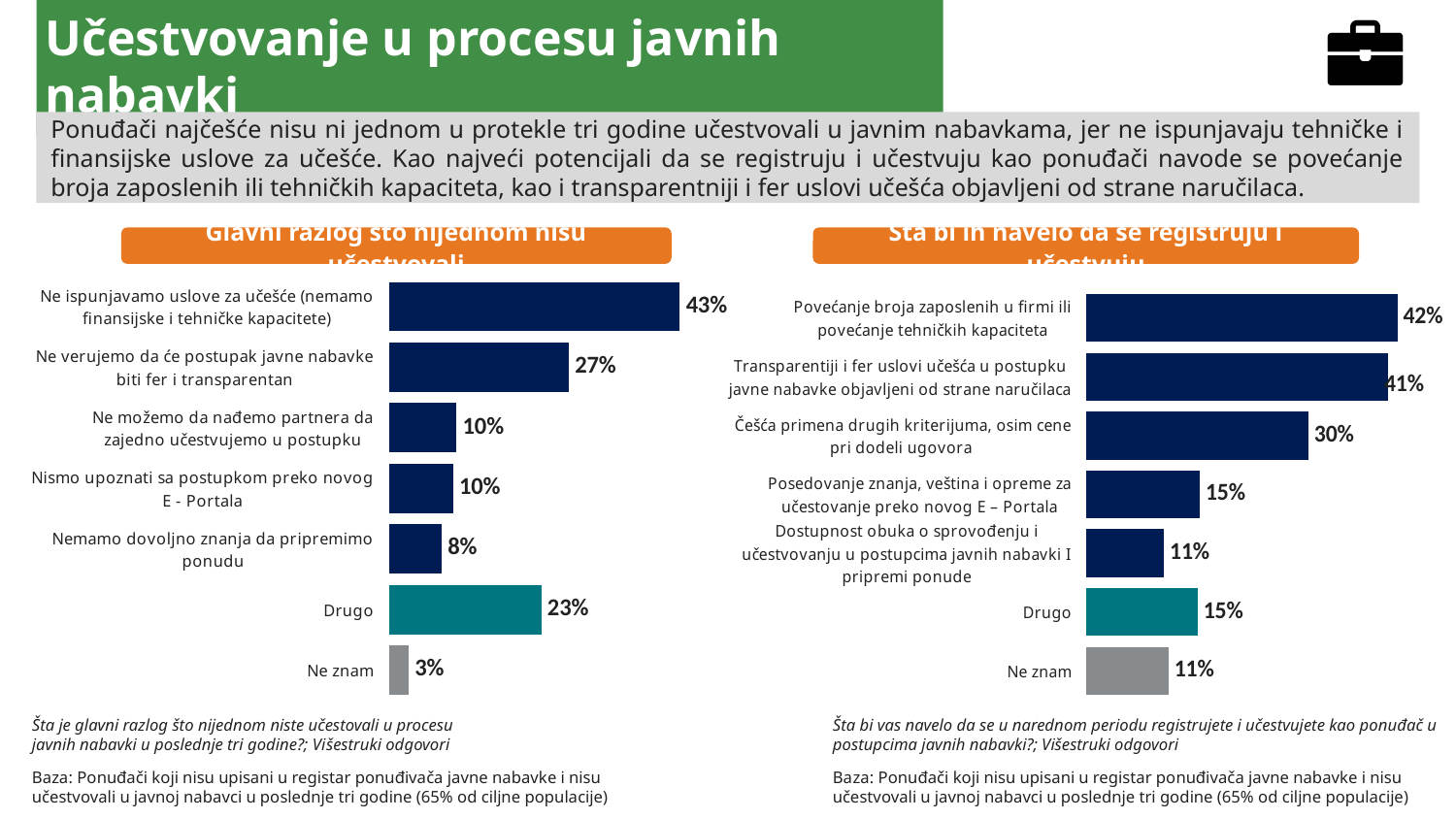
In the left chart, what colour is the bar for "Ne znam"? Grey In the right chart (Šta bi ih navelo da se registruju i učestvuju), what is the value for "Češća primena drugih kriterijuma, osim cene pri dodeli ugovora"? 30% In the left chart (Glavni razlog što nijednom nisu učestvovali), what is the value for "Ne ispunjavamo uslove za učešće (nemamo finansijske i tehničke kapacitete)"? 43% In the left chart, what is the difference between "Ne ispunjavamo uslove za učešće" and "Ne verujemo da će postupak javne nabavke biti fer i transparentan"? 16% In the left chart, what is the value for "Drugo"? 23% In the left chart, how many categories are shown? 7 In the left chart, which category has the lowest value? Ne znam In the right chart, which is larger: "Posedovanje znanja, veština i opreme za učestovanje preko novog E – Portala" or "Dostupnost obuka o sprovođenju i učestvovanju u postupcima javnih nabavki I pripremi ponude"? Posedovanje znanja, veština i opreme za učestovanje preko novog E – Portala What type of chart is used on the left side of the slide? Bar chart In the right chart, which category has the highest value? Povećanje broja zaposlenih u firmi ili povećanje tehničkih kapaciteta In the right chart, what is the value for "Transparentiji i fer uslovi učešća u postupku javne nabavke objavljeni od strane naručilaca"? 41% In the right chart, what is the difference between "Češća primena drugih kriterijuma, osim cene pri dodeli ugovora" and "Ne znam"? 19%